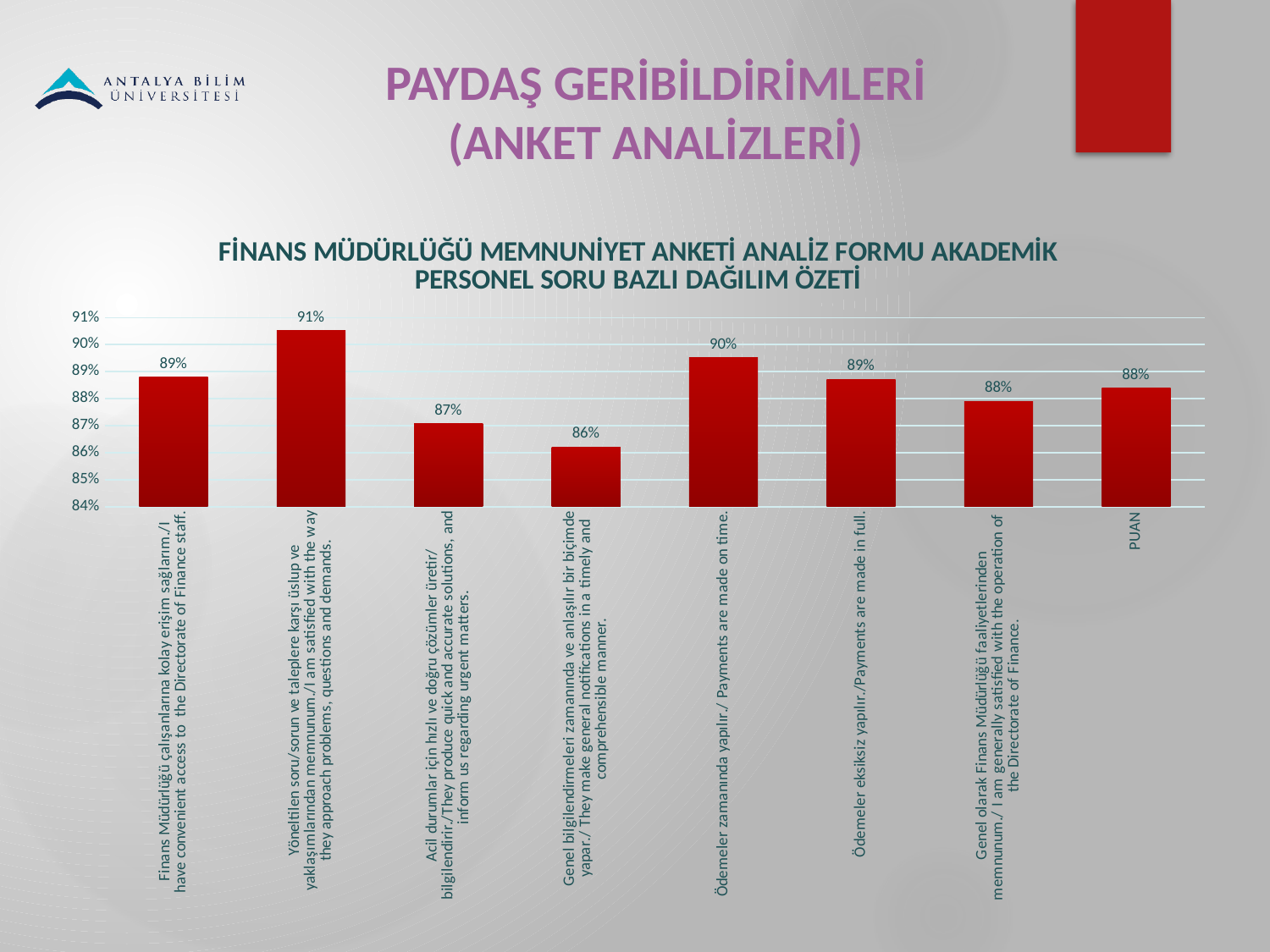
What kind of chart is shown on the slide? Bar chart What is the title of the chart? FİNANS MÜDÜRLÜĞÜ MEMNUNİYET ANKETİ ANALİZ FORMU AKADEMİK PERSONEL SORU BAZLI DAĞILIM ÖZETİ Is the value for "PUAN" greater or less than 87%? greater What is the difference between the highest value (91%) and the lowest value (86%)? 5 percentage points What is the value for "PUAN"? 88% Which category has the lowest value? Genel bilgilendirmeleri zamanında ve anlaşılır bir biçimde yapar./ They make general notifications in a timely and comprehensible manner. What is the value for "Acil durumlar için hızlı ve doğru çözümler üretir/bilgilendirir./They produce quick and accurate solutions, and inform us regarding urgent matters."? 87% Which category has the highest value? Yöneltilen soru/sorun ve taleplere karşı üslup ve yaklaşımlarından memnunum./I am satisfied with the way they approach problems, questions and demands. What is the value for "Genel olarak Finans Müdürlüğü faaliyetlerinden memnunum./ I am generally satisfied with the operation of the Directorate of Finance."? 88% How many bars are plotted in the chart? 8 Which is larger: the value for "Payments are made on time" or the value for "Payments are made in full"? Payments are made on time What is the value for "Ödemeler zamanında yapılır./ Payments are made on time."? 90%